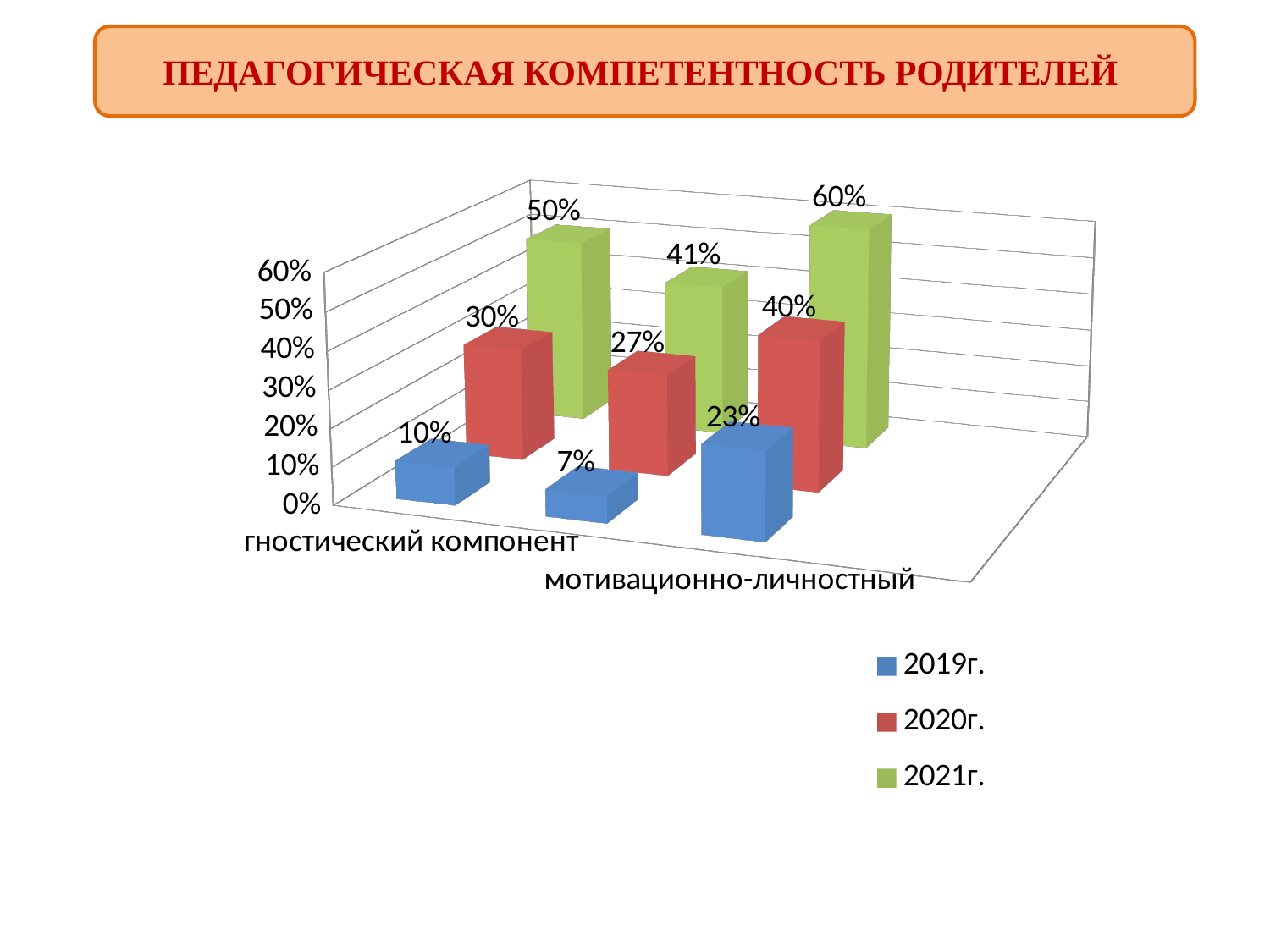
What is the value for 2019г. in the гностический компонент category? 10% What is the lowest value shown in the chart? 7% Which is larger in the гностический компонент category: the 2020г. value or the 2019г. value? 2020г. What type of chart is shown on the slide? bar chart How many category groups of bars are plotted in the chart? 3 What is the value for 2020г. in the гностический компонент category? 30% Do the values for each category rise or fall from 2019г. to 2021г.? rise What is the difference between the 2021г. and 2019г. values in the гностический компонент category? 40% Which colour represents 2021г. in the legend? green How many series does the legend list? 3 What is the highest value shown in the chart? 60% What is the value for 2021г. in the гностический компонент category? 50%